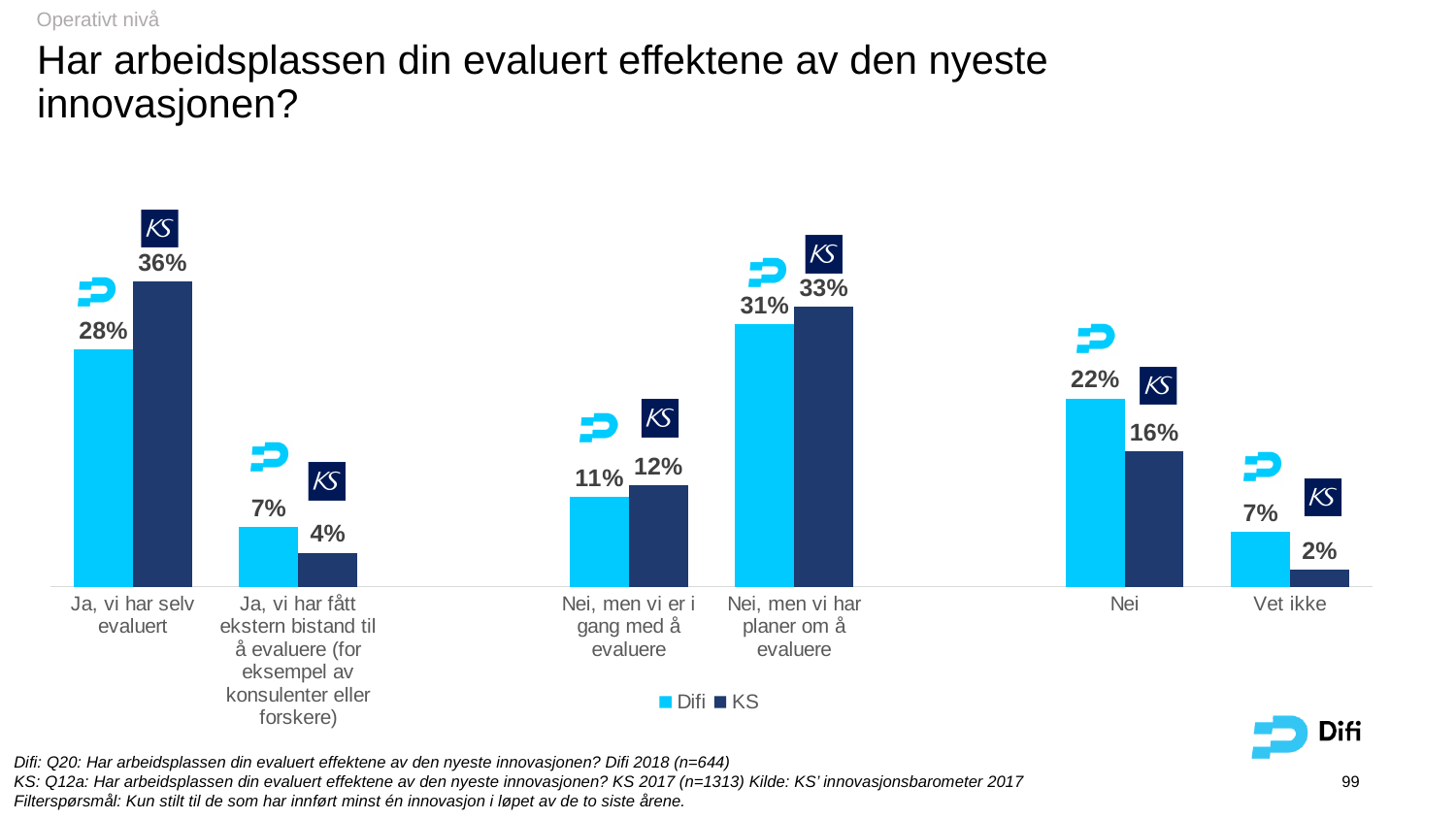
Which category has the highest KS value? Ja, vi har selv evaluert Which category has the highest Difi value? Nei, men vi har planer om å evaluere What is the KS value for "Vet ikke"? 2% What is the KS value for "Nei, men vi har planer om å evaluere"? 33% What is the Difi value for "Nei"? 22% What is the Difi value for "Ja, vi har selv evaluert"? 28% What kind of chart is shown on the slide? Bar chart Which category has the lowest KS value? Vet ikke For "Nei", which series has the larger value, Difi or KS? Difi How many categories are shown on the x axis? 6 How many series does the legend list? 2 What is the difference between the KS and Difi values for "Ja, vi har selv evaluert"? 8%